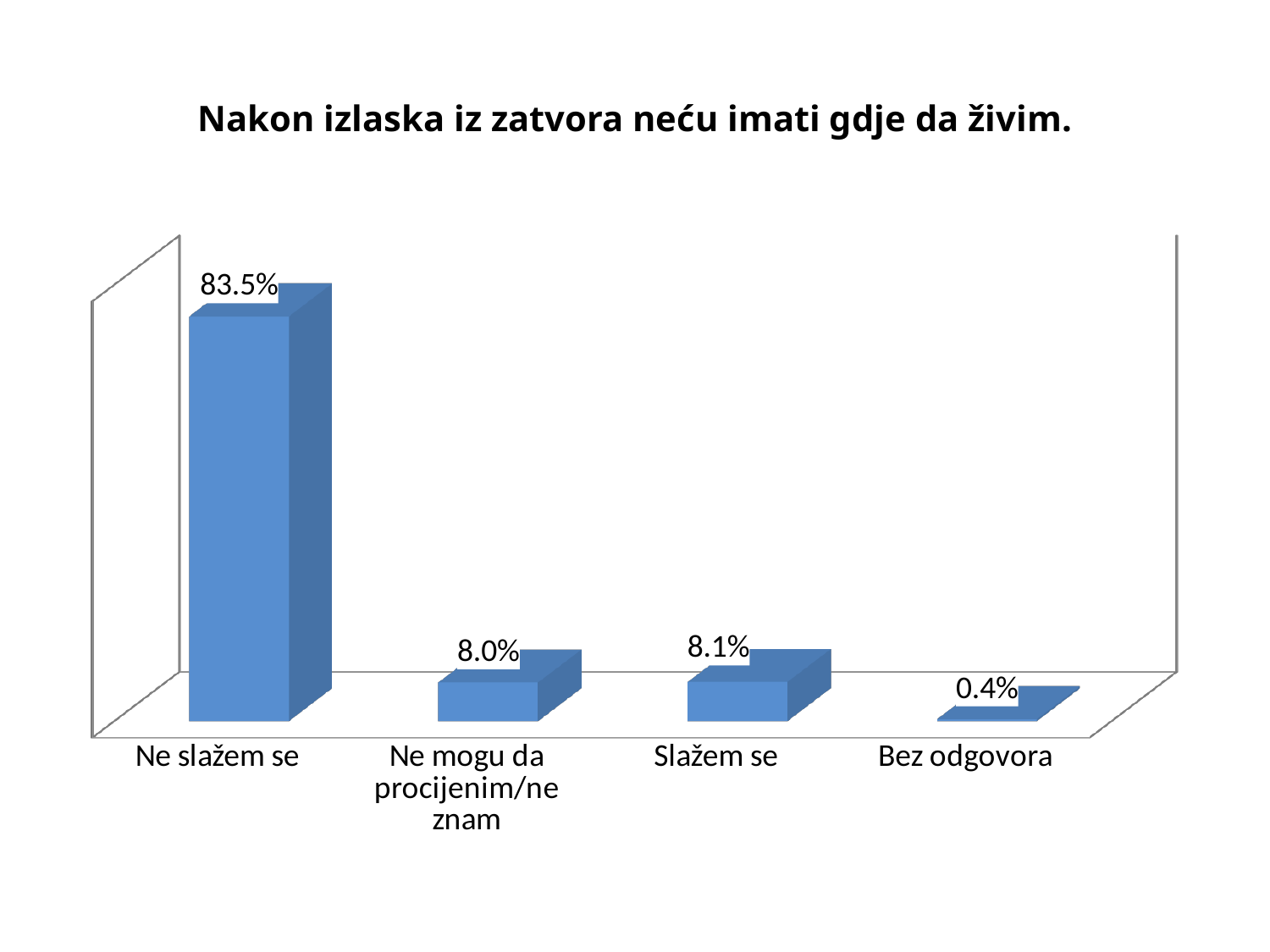
What is the value for Ne slažem se? 83.5% What is the title of the chart? Nakon izlaska iz zatvora neću imati gdje da živim. Which category has the highest value? Ne slažem se How many categories are shown in the chart? 4 What is the value for Slažem se? 8.1% What is the difference between the values for Slažem se and Bez odgovora? 7.7% What is the value for Bez odgovora? 0.4% What is the value for Ne mogu da procijenim/ne znam? 8.0% What kind of chart is shown on the slide? Bar chart What is the difference between the values for Ne slažem se and Slažem se? 75.4% Which category has the lowest value? Bez odgovora Which is larger, the value for Ne slažem se or the value for Ne mogu da procijenim/ne znam? Ne slažem se